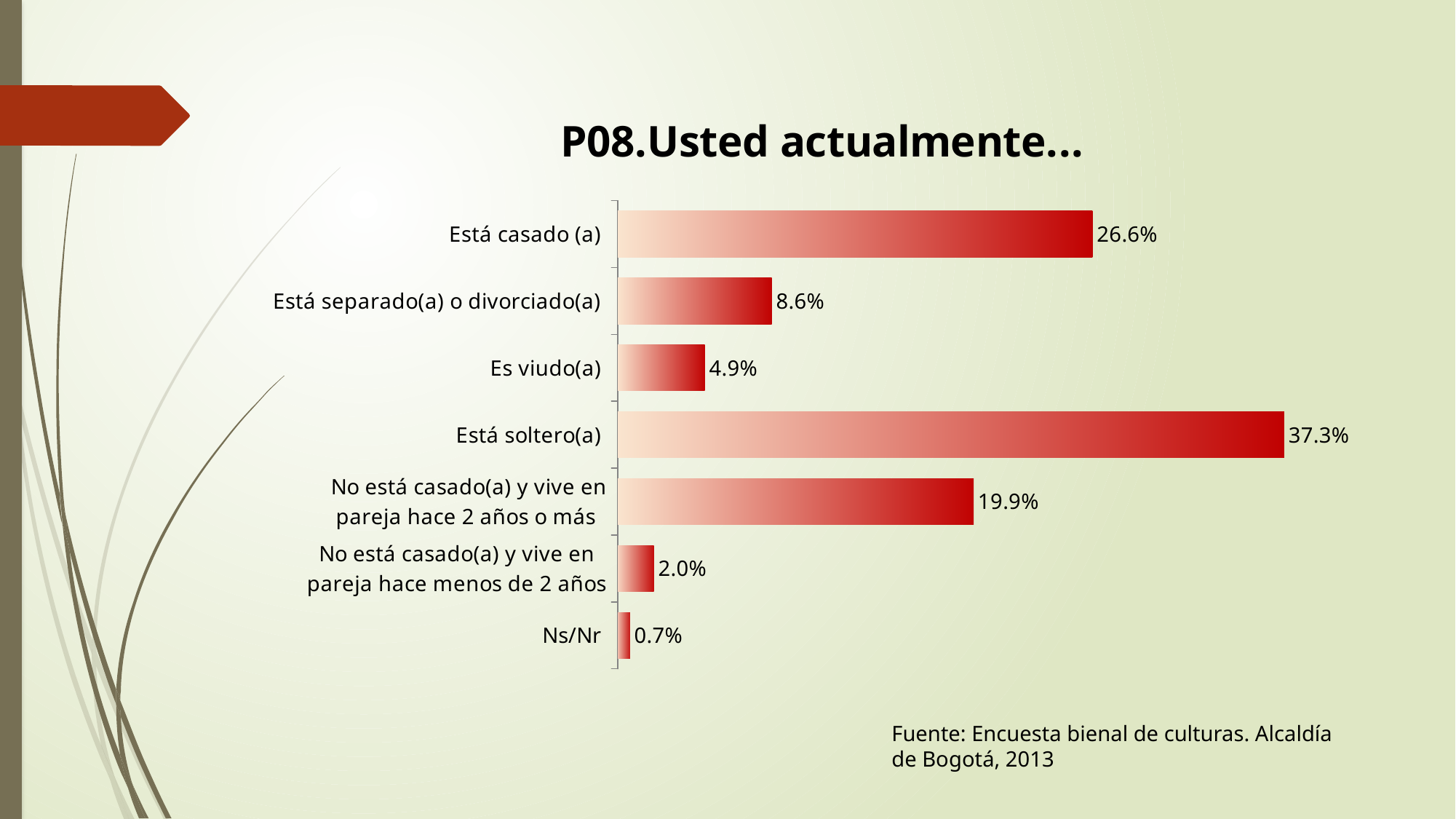
What is the value for "Está casado (a)"? 26.6% What is the value for "No está casado(a) y vive en pareja hace 2 años o más"? 19.9% What is the difference between the values for "Está soltero(a)" and "Está casado (a)"? 10.7% What is the title of the chart? P08.Usted actualmente... How many categories are shown in the chart? 7 What kind of chart is shown on the slide? Bar chart Which category has the highest value? Está soltero(a) What is the value for "Ns/Nr"? 0.7% What is the value for "Es viudo(a)"? 4.9% Which category has the lowest value? Ns/Nr Which is larger: the value for "Está separado(a) o divorciado(a)" or the value for "No está casado(a) y vive en pareja hace menos de 2 años"? Está separado(a) o divorciado(a) What is the difference between the values for "Está separado(a) o divorciado(a)" and "Es viudo(a)"? 3.7%